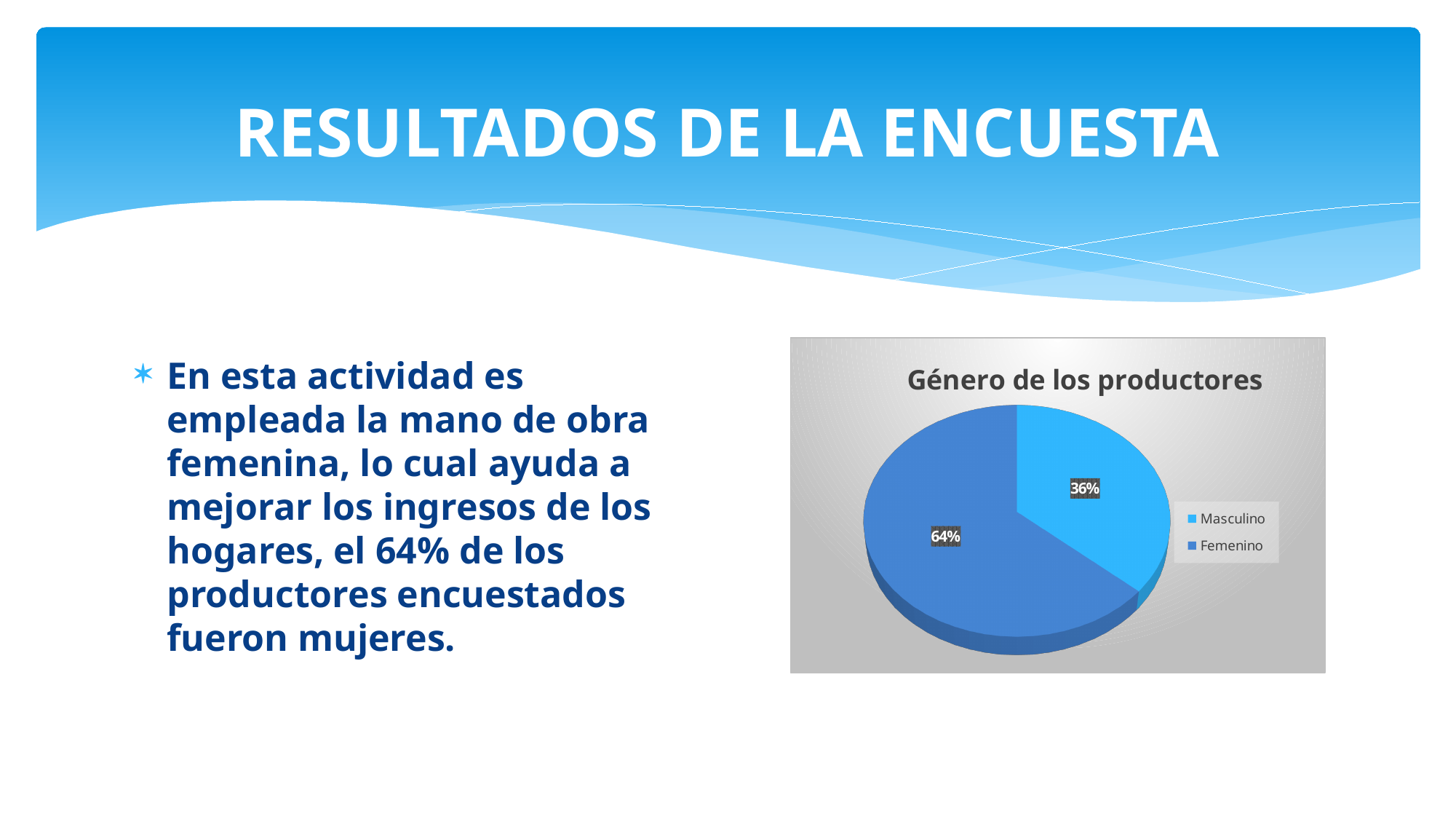
Which is larger, the Masculino slice or the Femenino slice? Femenino What kind of chart is shown on the slide? Pie chart Which category has the largest slice of the pie? Femenino Which category has the smallest slice of the pie? Masculino What share of the pie does Femenino represent? 64% What is the total of the two slices shown in the pie chart? 100% How many categories does the pie chart show? 2 What is the title of the chart? Género de los productores What is the difference in percentage points between the Femenino and Masculino slices? 28% What share of the pie does Masculino represent? 36% Which legend entry is shown in the lighter blue colour? Masculino